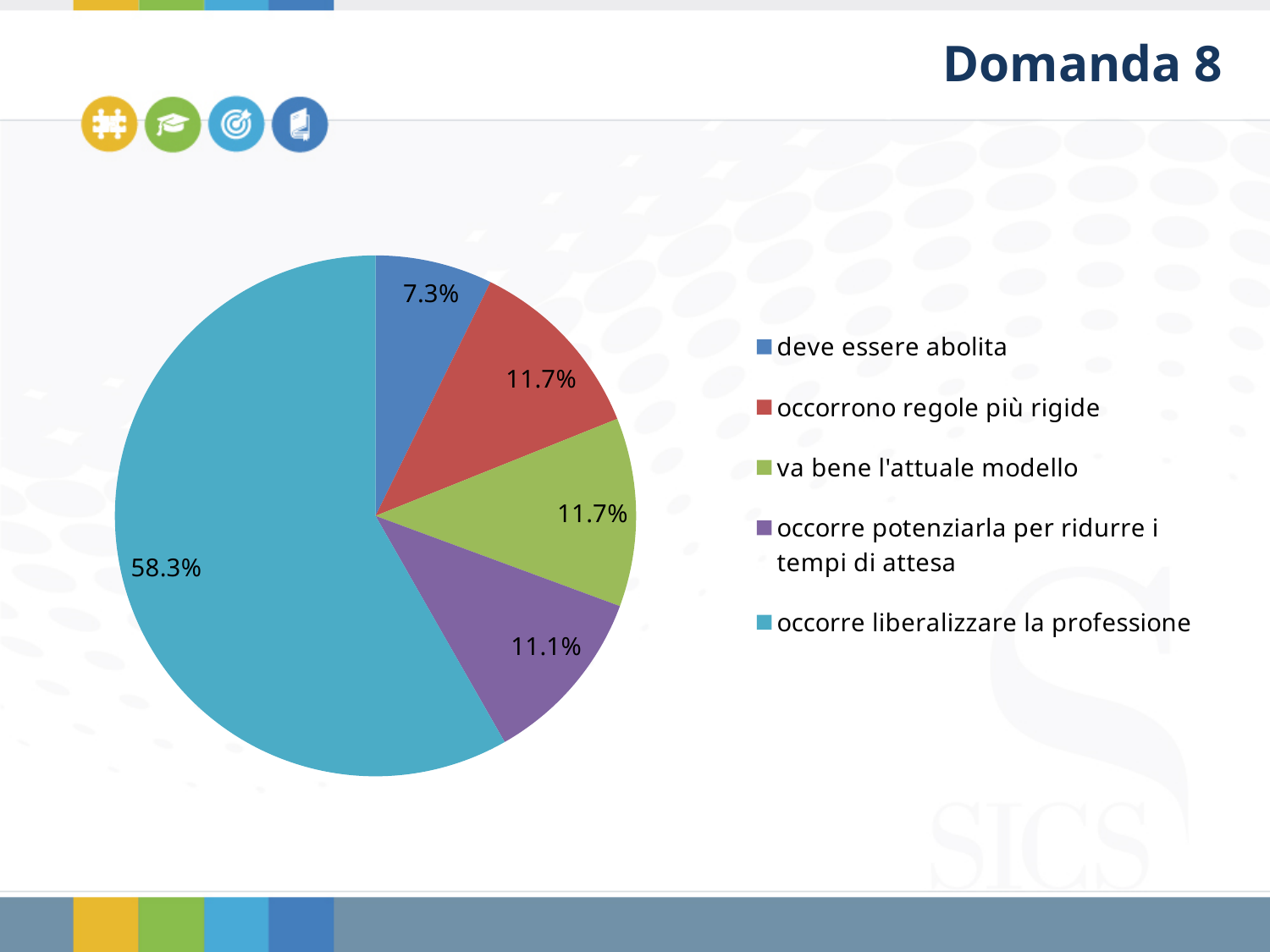
Which category has the largest slice of the pie? occorre liberalizzare la professione Which category has the smallest slice of the pie? deve essere abolita What share of the pie is labelled for "deve essere abolita"? 7.3% What kind of chart is shown on the slide? pie chart Which is larger: the slice for "occorrono regole più rigide" or the slice for "deve essere abolita"? occorrono regole più rigide What is the title shown at the top of the slide? Domanda 8 What share of the pie is labelled for "occorrono regole più rigide"? 11.7% What share of the pie is labelled for "va bene l'attuale modello"? 11.7% How many slices does the pie chart have? 5 What share of the pie is labelled for "occorre potenziarla per ridurre i tempi di attesa"? 11.1% What is the difference in percentage points between "occorre liberalizzare la professione" and "deve essere abolita"? 51.0 percentage points What share of the pie is labelled for "occorre liberalizzare la professione"? 58.3%